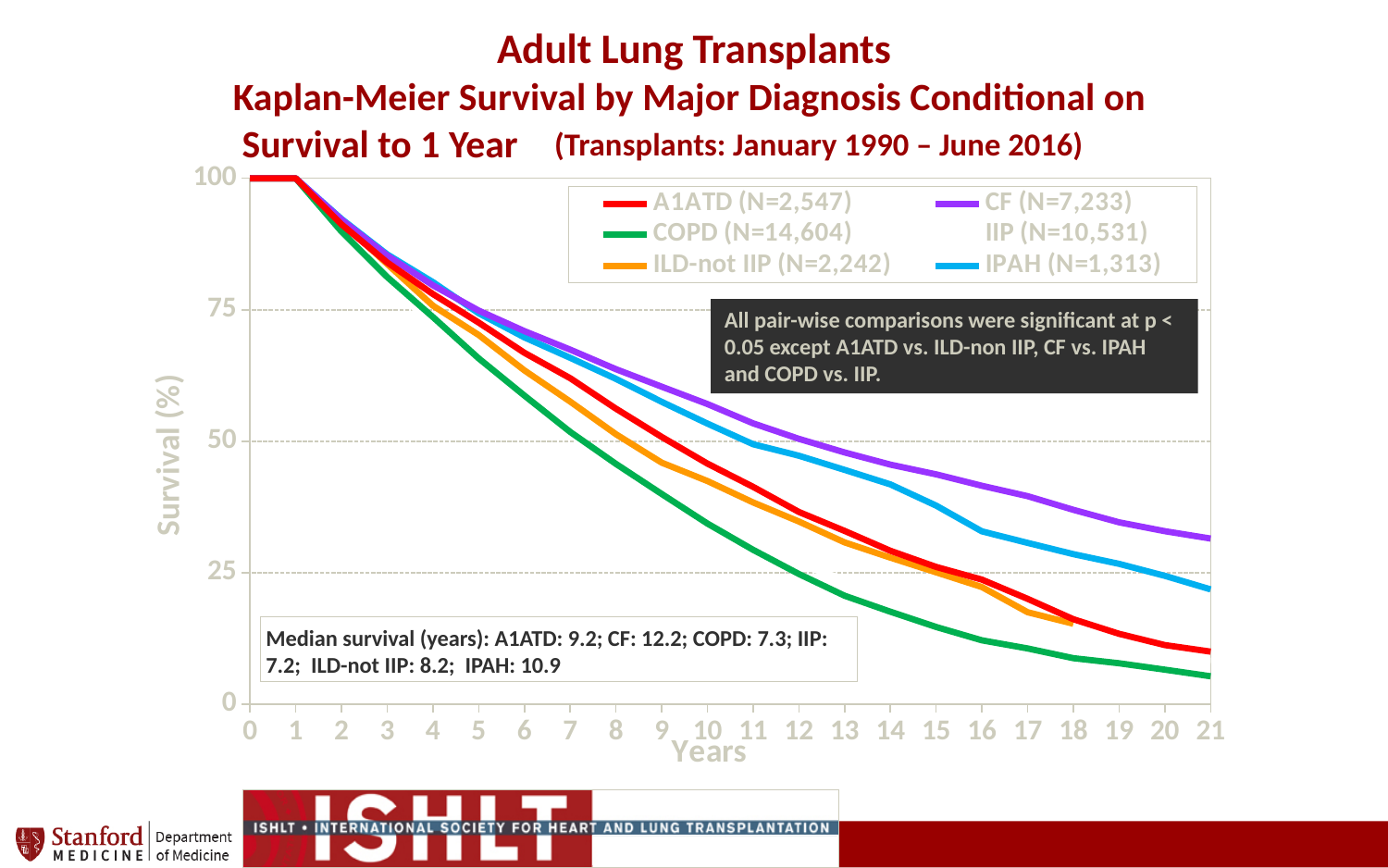
What kind of chart is shown on the slide? line chart Is the survival for COPD at 10 years greater or less than 50%? less According to the text box, what is the median survival in years for IIP? 7.2 Do the survival curves rise or fall as years increase? fall Which diagnosis group has the lowest survival at 15 years? COPD What is the N shown in the legend for COPD? N=14,604 Is the survival for CF at 20 years greater or less than 25%? greater According to the text box, what is the median survival in years for CF? 12.2 How many series does the chart legend list? 6 Is the survival for COPD at 20 years greater or less than 25%? less Which diagnosis group has the highest survival at 15 years? CF